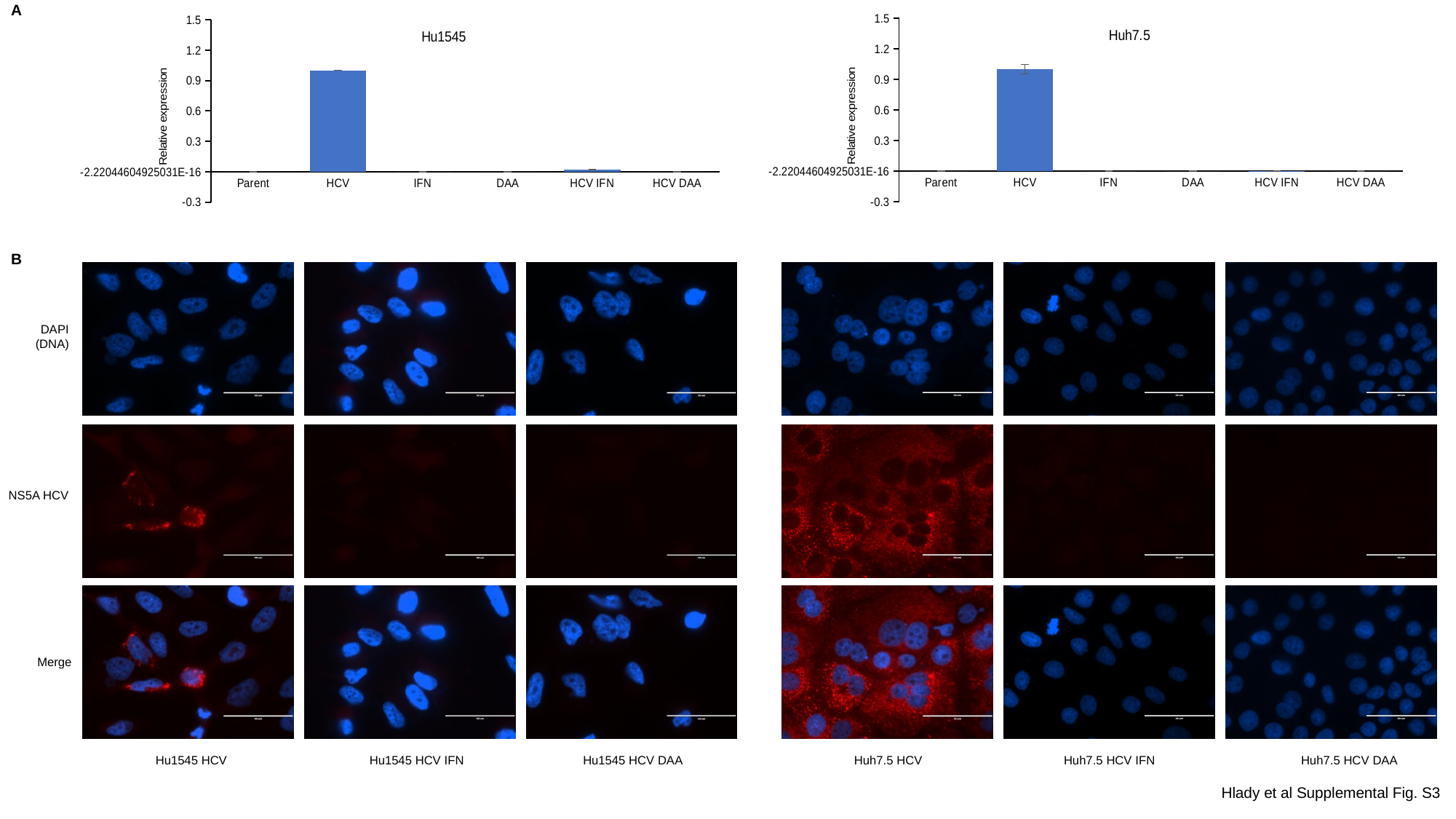
What kind of chart is the Hu1545 chart? Bar chart What is the y-axis label of the Huh7.5 chart? Relative expression How many categories are shown on the x axis of the Hu1545 chart? 6 In the Hu1545 chart, which category has the highest relative expression? HCV How many categories are shown on the x axis of the Huh7.5 chart? 6 In the Hu1545 chart, is the value for HCV greater or less than 0.9? greater In the Hu1545 chart, is the value for HCV greater or less than 1.2? less In the Huh7.5 chart, which category has the highest relative expression? HCV In the Hu1545 chart, which is larger, the value for HCV or the value for Parent? HCV In the Huh7.5 chart, is the value for HCV greater or less than 1.2? less In the Huh7.5 chart, which is larger, the value for HCV or the value for HCV IFN? HCV